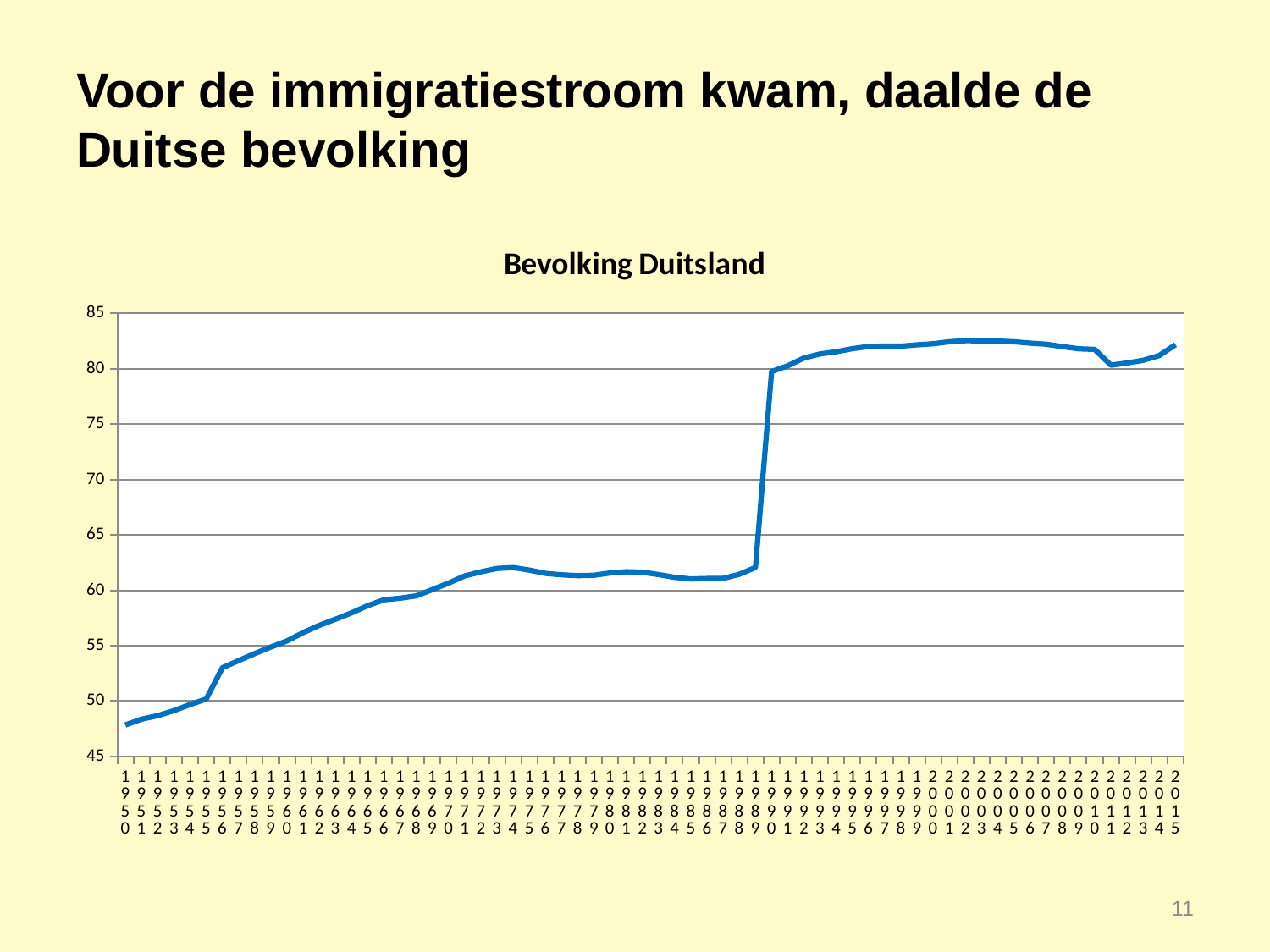
Which year has the larger value, 1960 or 1980? 1980 Is the value for 1980 greater or less than 60? greater Do the values rise or fall from 1950 to 1970? rise What is the title of the chart? Bevolking Duitsland Is the value for 1950 greater or less than 50? less Is the value for 1990 greater or less than 75? greater Which year has the larger value, 1989 or 1990? 1990 Which year has the lowest value on the chart? 1950 How many years (data points) are plotted along the x axis, from 1950 to 2015? 66 What kind of chart is shown on the slide? line chart